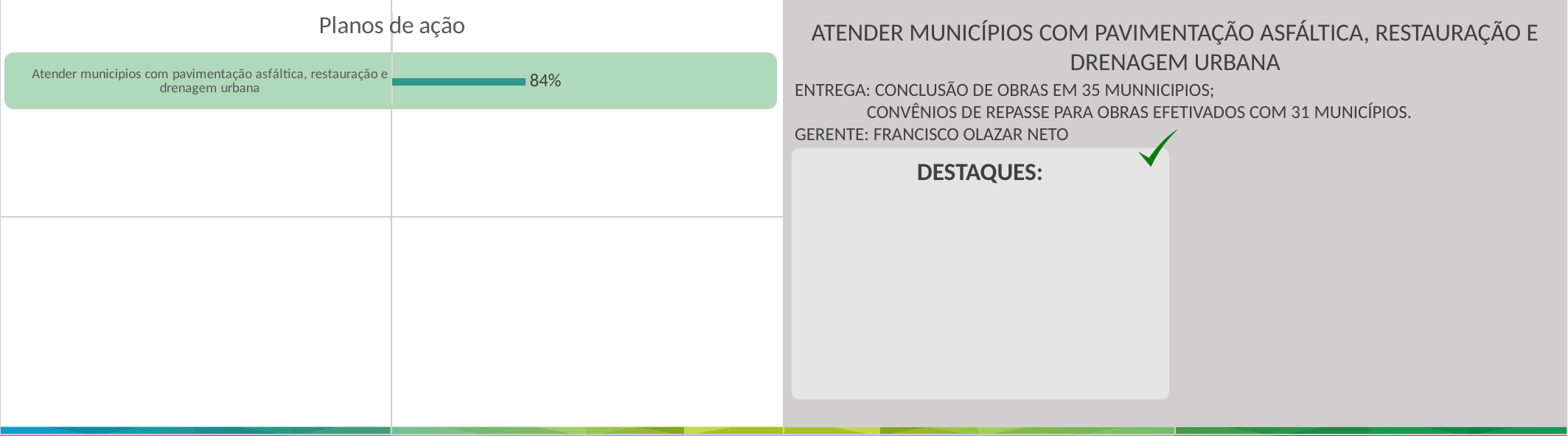
What is the title of the chart on the left side of the slide? Planos de ação Is the value for "Atender municipios com pavimentação asfáltica, restauração e drenagem urbana" in the Planos de ação chart greater or less than 50%? greater What is the value shown for "Atender municipios com pavimentação asfáltica, restauração e drenagem urbana" in the Planos de ação chart? 84% Which category has the highest value in the Planos de ação chart? Atender municipios com pavimentação asfáltica, restauração e drenagem urbana What kind of chart is the Planos de ação chart? Bar chart How many categories are plotted in the Planos de ação chart? 1 Are the bars in the Planos de ação chart horizontal or vertical? Horizontal